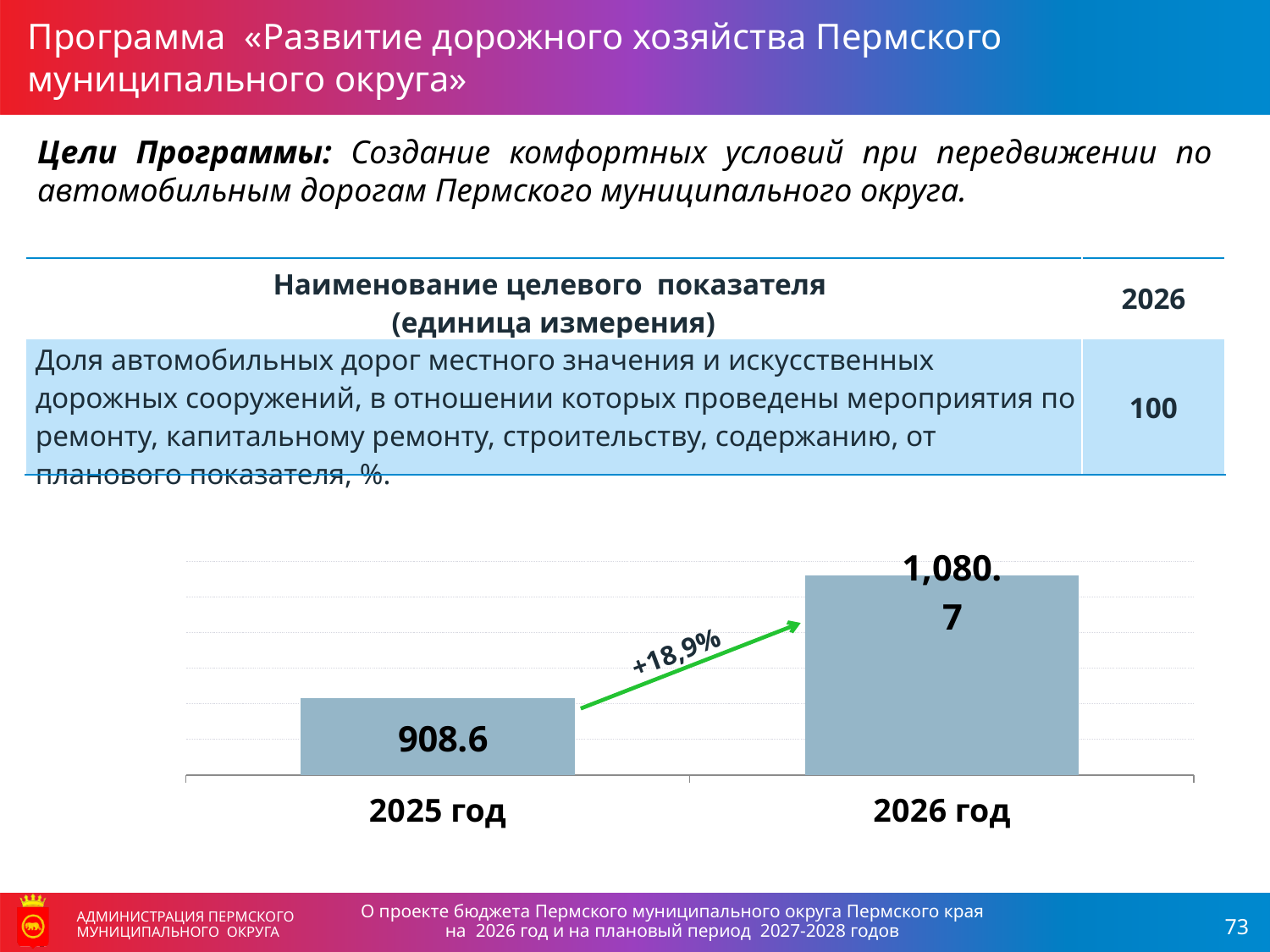
How many bars are shown in the chart? 2 What is the difference between the values for 2026 год and 2025 год? 172.1 Which year has the highest value? 2026 год What colour is the arrow between the two bars? Green What kind of chart is shown on the slide? Bar chart What is the value for 2025 год? 908.6 Which is larger, the value for 2025 год or the value for 2026 год? 2026 год What percentage change is written next to the arrow between the two bars? +18,9% Do the values rise or fall from 2025 год to 2026 год? Rise What is the value for 2026 год? 1,080.7 Which year has the lowest value? 2025 год